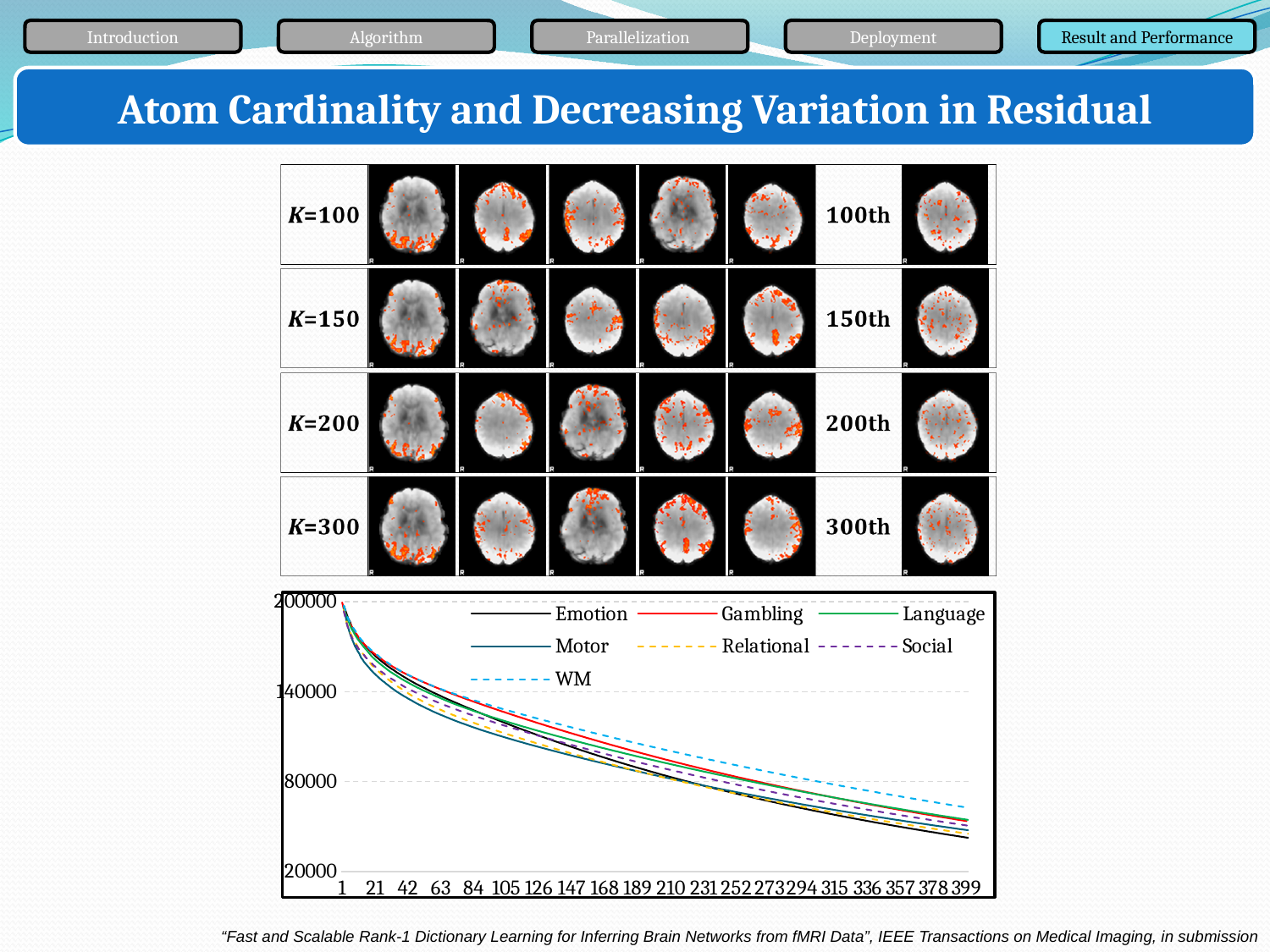
Which series are listed in the legend of the line chart? Emotion, Gambling, Language, Motor, Relational, Social, WM At x = 399, is the value for Emotion greater or less than 80000? less What is the highest value labelled on the y axis of the line chart? 200000 At x = 21, is the value for Gambling greater or less than 140000? greater What is the last tick label on the x axis of the line chart? 399 At x = 399, is the value for WM greater or less than 80000? less Which series has the highest value at x = 399 in the line chart? WM At x = 399, which is larger, the value for WM or the value for Emotion? WM How many series does the legend of the line chart list? 7 What kind of chart is shown at the bottom of the slide? line chart Do the values in the line chart rise or fall as the x axis increases from 1 to 399? fall How many tick labels are shown on the x axis of the line chart? 20